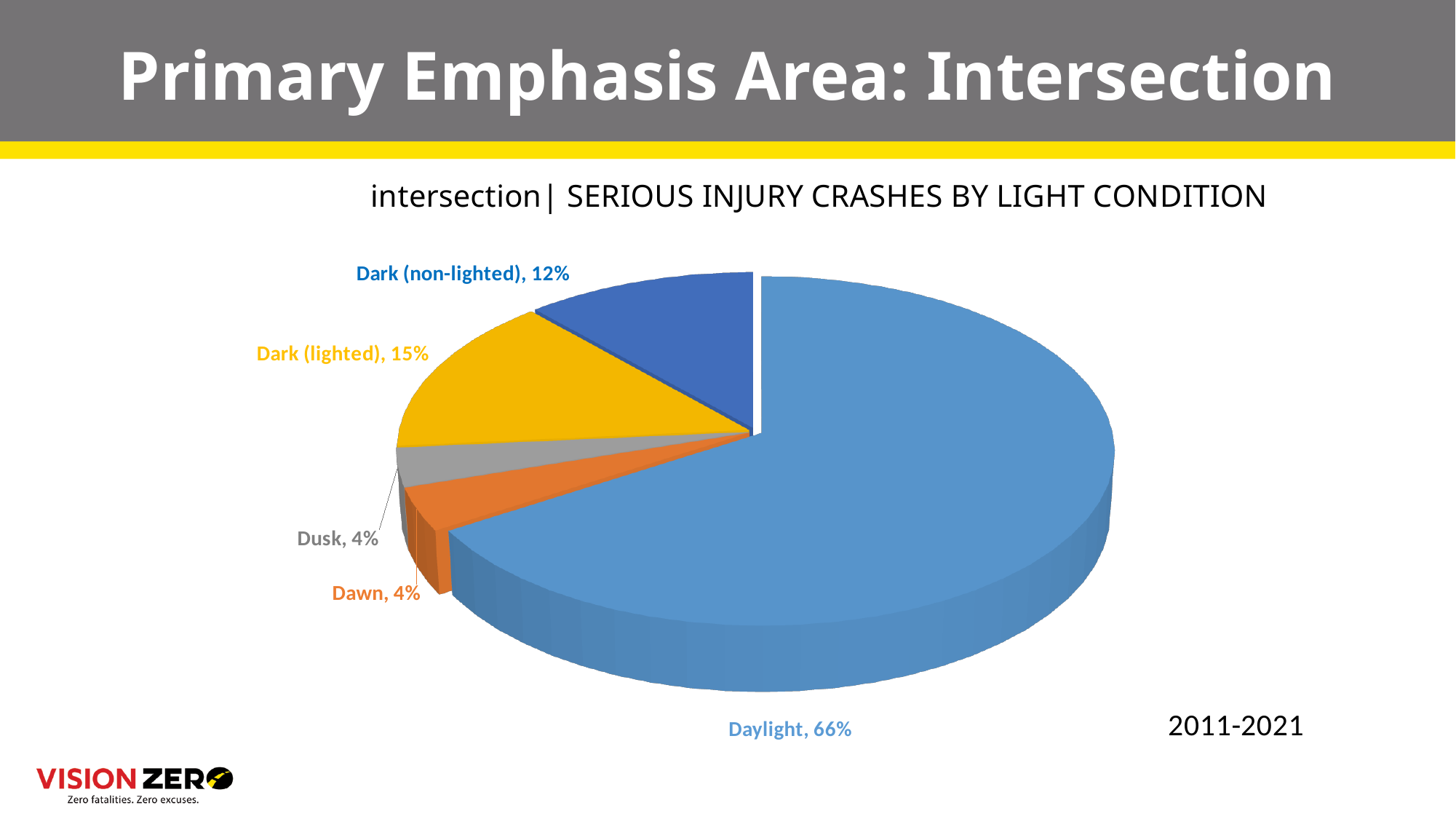
What is the difference in percentage points between the Dark (lighted) and Dark (non-lighted) shares? 3% What time period does the chart cover, as shown on the slide? 2011-2021 What kind of chart is shown on the slide? Pie chart What share of serious injury crashes at intersections occurred in Dark (non-lighted) conditions? 12% What share of serious injury crashes at intersections occurred in Daylight? 66% What share of serious injury crashes at intersections occurred in Dark (lighted) conditions? 15% Which is larger, the share for Dark (lighted) or the share for Dark (non-lighted)? Dark (lighted) How many light condition categories are shown in the pie chart? 5 Which light condition has the largest share of serious injury crashes at intersections? Daylight What is the difference in percentage points between the Daylight share and the Dark (lighted) share? 51% What is the title of the chart? intersection| SERIOUS INJURY CRASHES BY LIGHT CONDITION